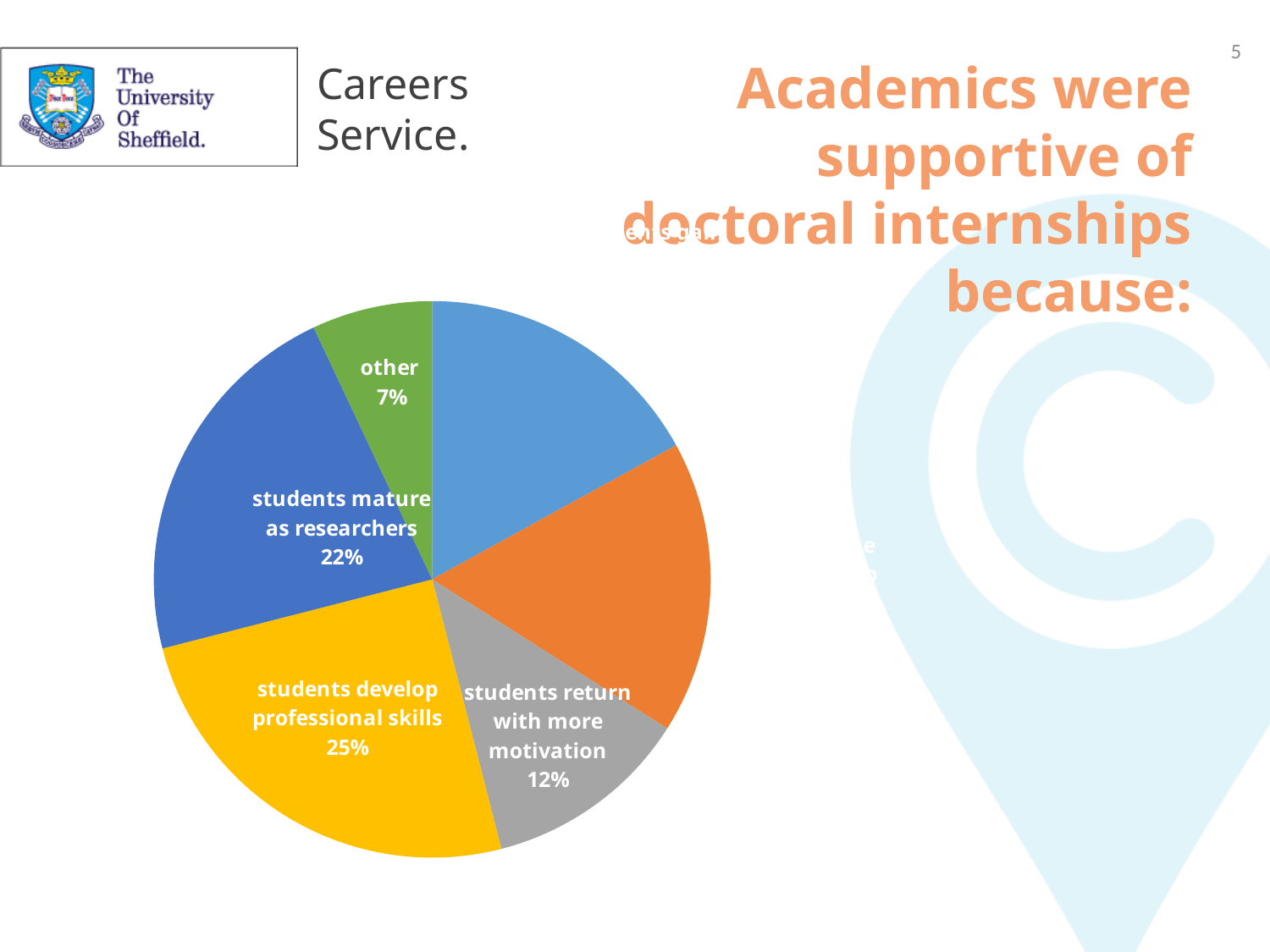
How many percentage points larger is 'students develop professional skills' than 'students mature as researchers'? 3 What kind of chart is shown on the slide? pie chart Which is larger: the share for 'students develop professional skills' or the share for 'students mature as researchers'? students develop professional skills What percentage of the pie is labelled 'students return with more motivation'? 12% What colour is the 'other' slice of the pie chart? green Which slice of the pie chart is the smallest? other What percentage of the pie is labelled 'other'? 7% What percentage of the pie is labelled 'students mature as researchers'? 22% How many percentage points larger is 'students mature as researchers' than 'students return with more motivation'? 10 What percentage of the pie is labelled 'students develop professional skills'? 25% Which slice of the pie chart is the largest? students develop professional skills How many slices does the pie chart have? 6